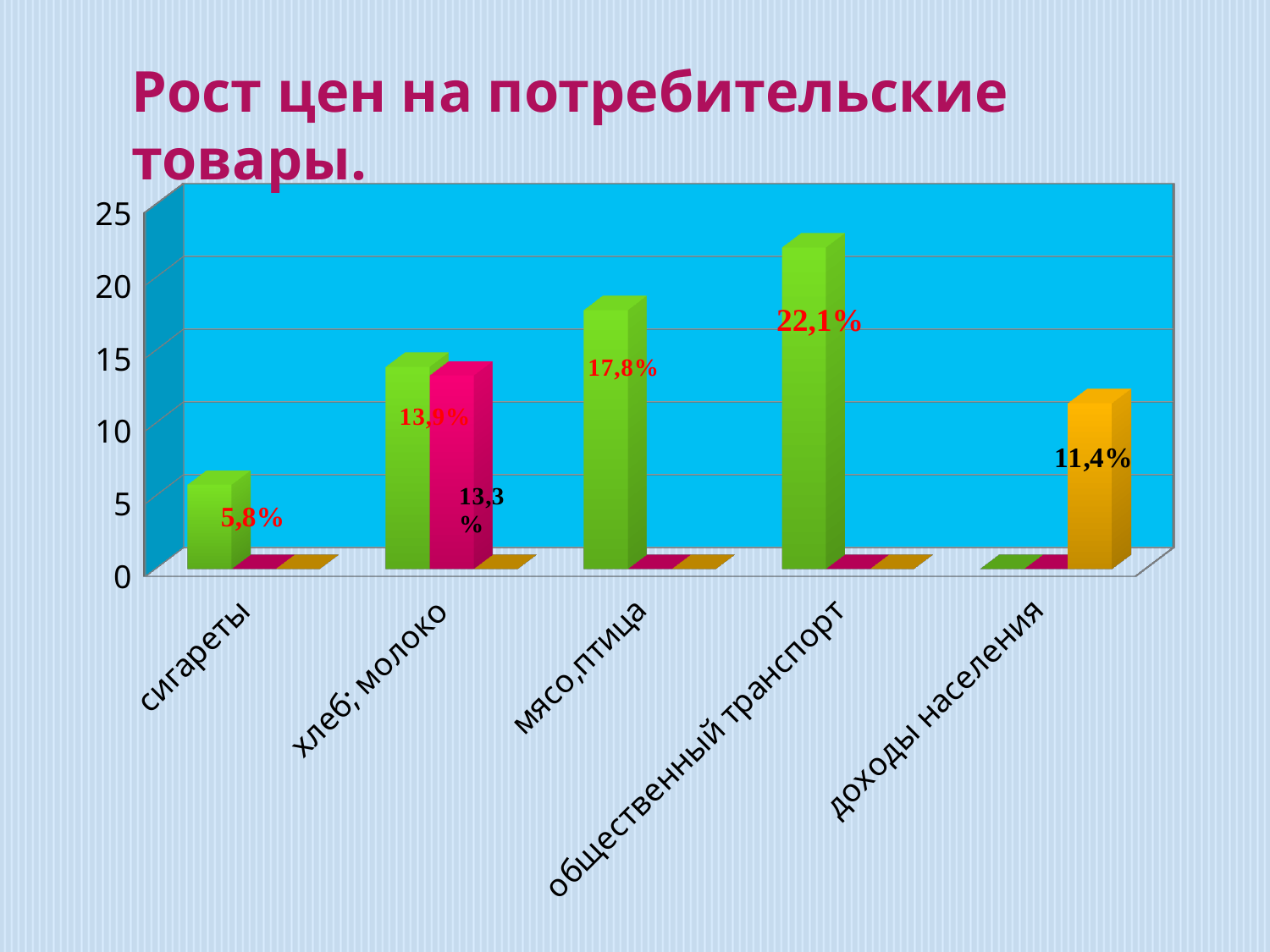
Which is larger, the value for мясо,птица or the value for доходы населения? мясо,птица What is the value shown for сигареты? 5,8% What is the value shown for доходы населения? 11,4% How many categories are shown on the x axis? 5 What is the value shown for мясо,птица? 17,8% What is the difference between the values for общественный транспорт and мясо,птица? 4,3% What is the title of the chart? Рост цен на потребительские товары. Which category has the lowest value? сигареты Which category has the highest value? общественный транспорт Is the value for общественный транспорт greater or less than 20? greater What is the value shown for общественный транспорт? 22,1% What is the value of the pink (second) bar for хлеб; молоко? 13,3%